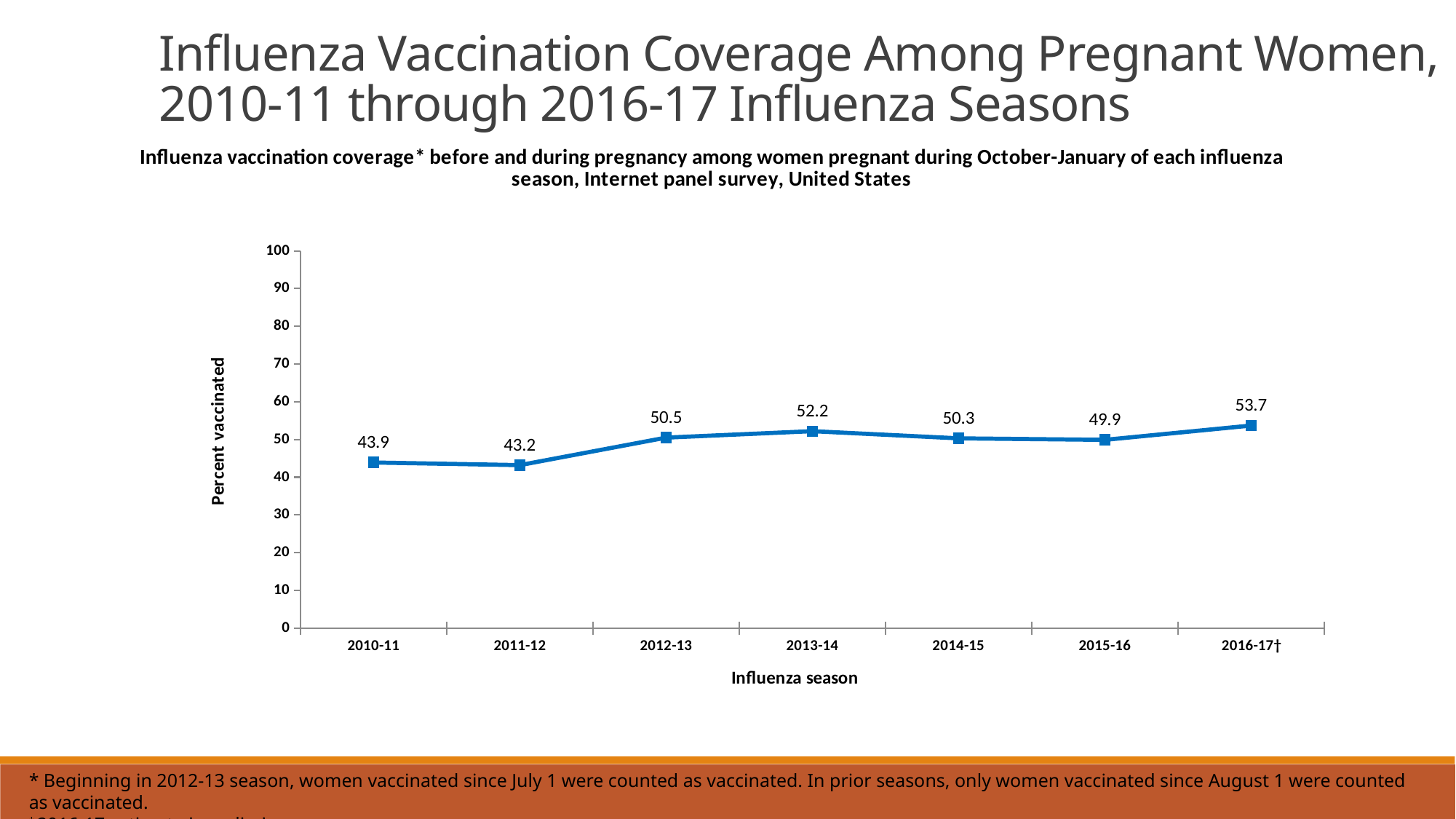
Which season has a higher percent vaccinated, 2012-13 or 2011-12? 2012-13 Is the percent vaccinated for 2015-16 greater or less than 60? less What is the percent vaccinated for the 2016-17 influenza season? 53.7 What is the difference in percent vaccinated between the 2013-14 and 2012-13 seasons? 1.7 Which influenza season has the highest percent vaccinated? 2016-17 What is the percent vaccinated for the 2010-11 influenza season? 43.9 Which influenza season has the lowest percent vaccinated? 2011-12 How many influenza seasons are plotted on the chart? 7 What is the percent vaccinated for the 2013-14 influenza season? 52.2 What is the difference in percent vaccinated between the 2016-17 and 2010-11 seasons? 9.8 What is the label of the y axis? Percent vaccinated What kind of chart is shown on the slide? line chart